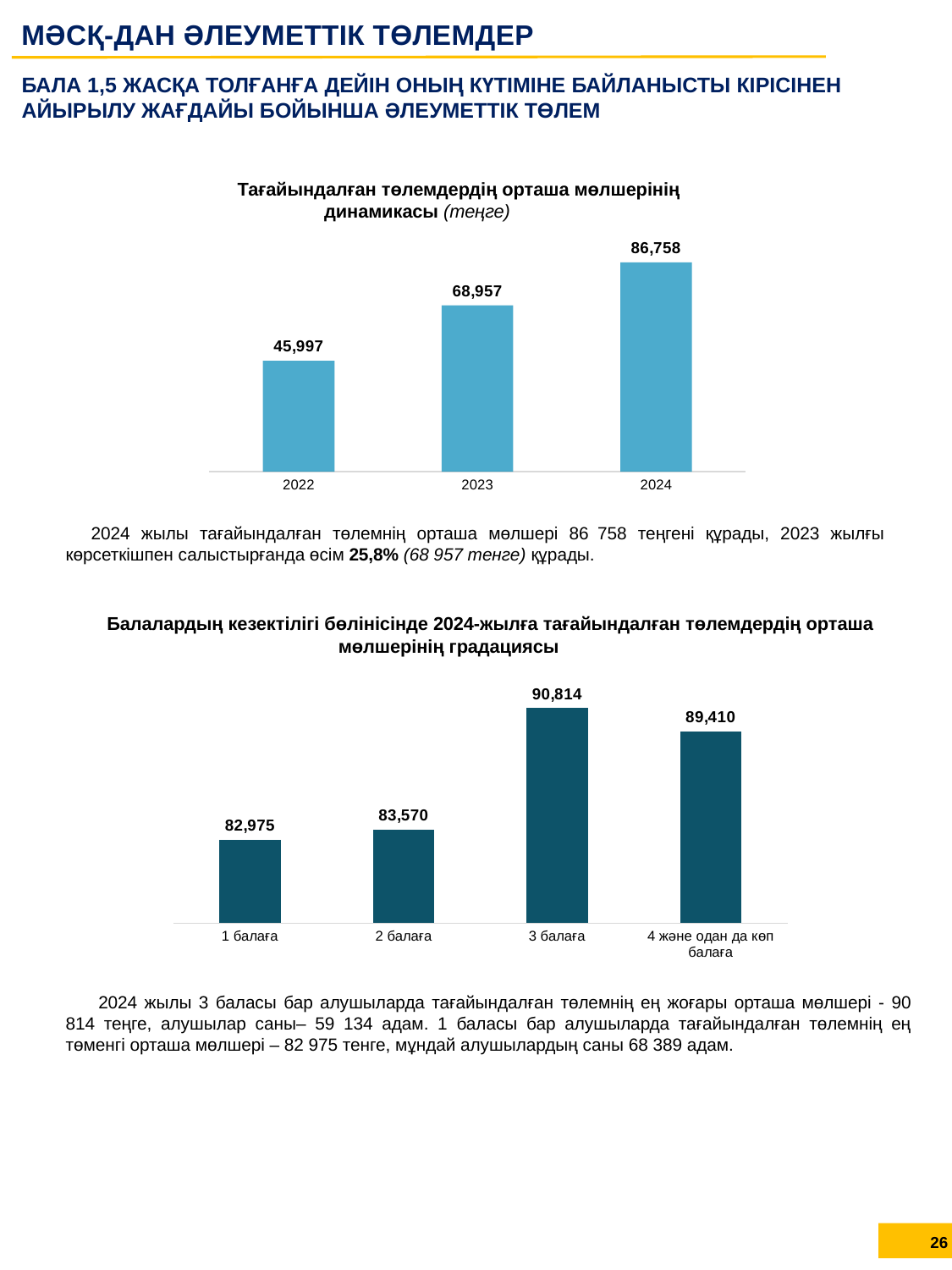
What kind of chart is the top chart? bar chart In the bottom chart, what is the value for 4 және одан да көп балаға? 89,410 In the bottom chart, which category has the lowest value? 1 балаға In the top chart, how many years are shown? 3 In the top chart (Тағайындалған төлемдердің орташа мөлшерінің динамикасы), what is the value for 2024? 86,758 In the top chart, what is the difference between the 2024 and 2023 values? 17,801 In the bottom chart, what is the difference between the values for 3 балаға and 1 балаға? 7,839 In the top chart, what is the value for 2022? 45,997 In the bottom chart (Балалардың кезектілігі бөлінісінде...), which category has the highest value? 3 балаға In the bottom chart, what is the value for 2 балаға? 83,570 In the top chart, do the values rise or fall from 2022 to 2024? rise In the bottom chart, how many categories are shown? 4